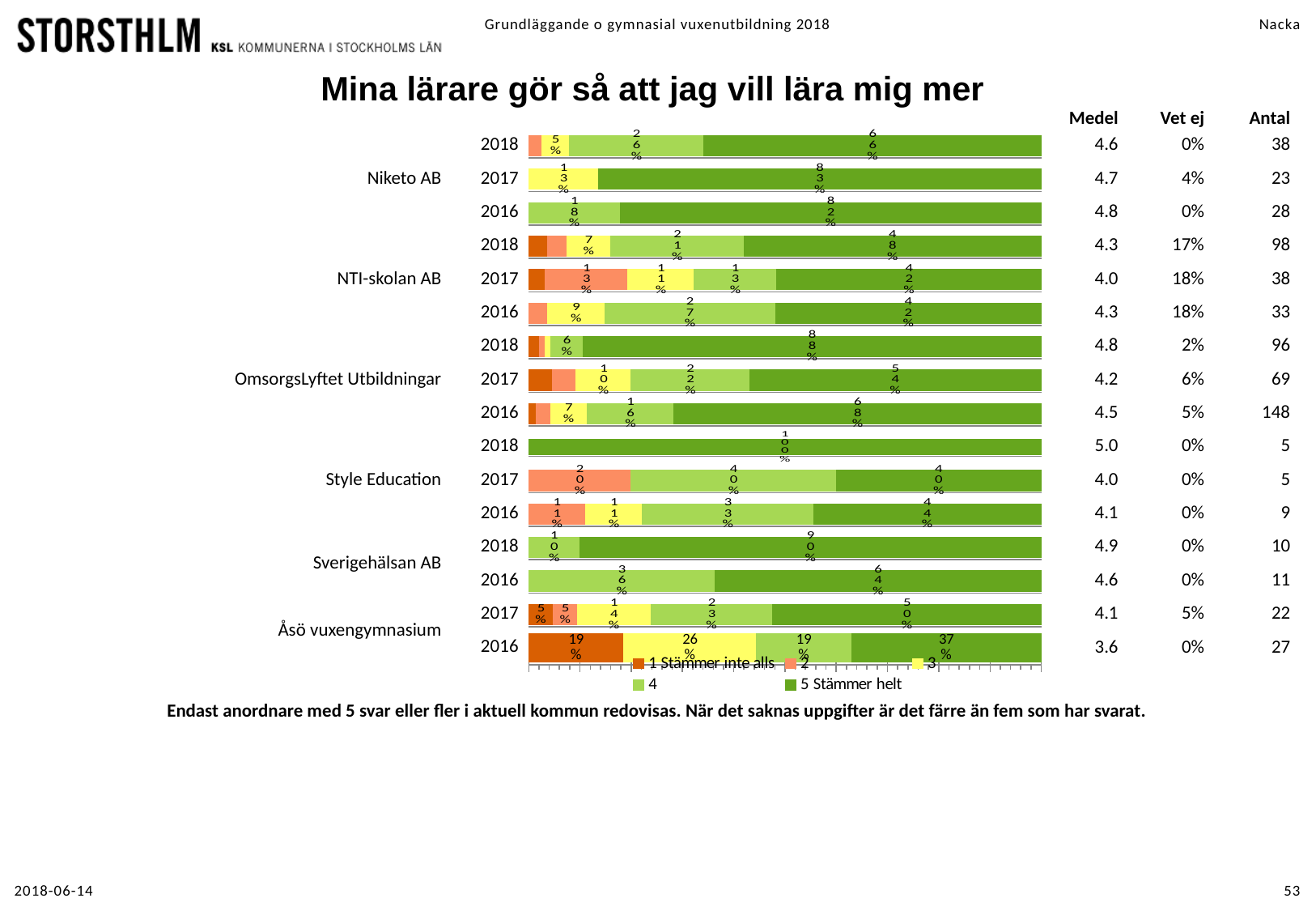
What is the value of the '5 Stämmer helt' segment for OmsorgsLyftet Utbildningar in 2018? 88% What is the value of the '1 Stämmer inte alls' segment for Åsö vuxengymnasium in 2016? 19% What kind of chart is shown on the slide? Stacked bar chart What is the value of the '5 Stämmer helt' segment for NTI-skolan AB in 2017? 42% How many series does the legend list? 5 What is the title of the chart? Mina lärare gör så att jag vill lära mig mer What is the value of the '3' segment for Åsö vuxengymnasium in 2017? 14% What is the difference between the '5 Stämmer helt' segment for Sverigehälsan AB in 2018 and in 2016? 26% What is the value of the '4' segment for Sverigehälsan AB in 2016? 36% What is the value of the '5 Stämmer helt' segment for Style Education in 2018? 100% Which is larger: the '5 Stämmer helt' segment for Niketo AB in 2017 or for Niketo AB in 2018? Niketo AB 2017 What is the label of the first legend entry? 1 Stämmer inte alls